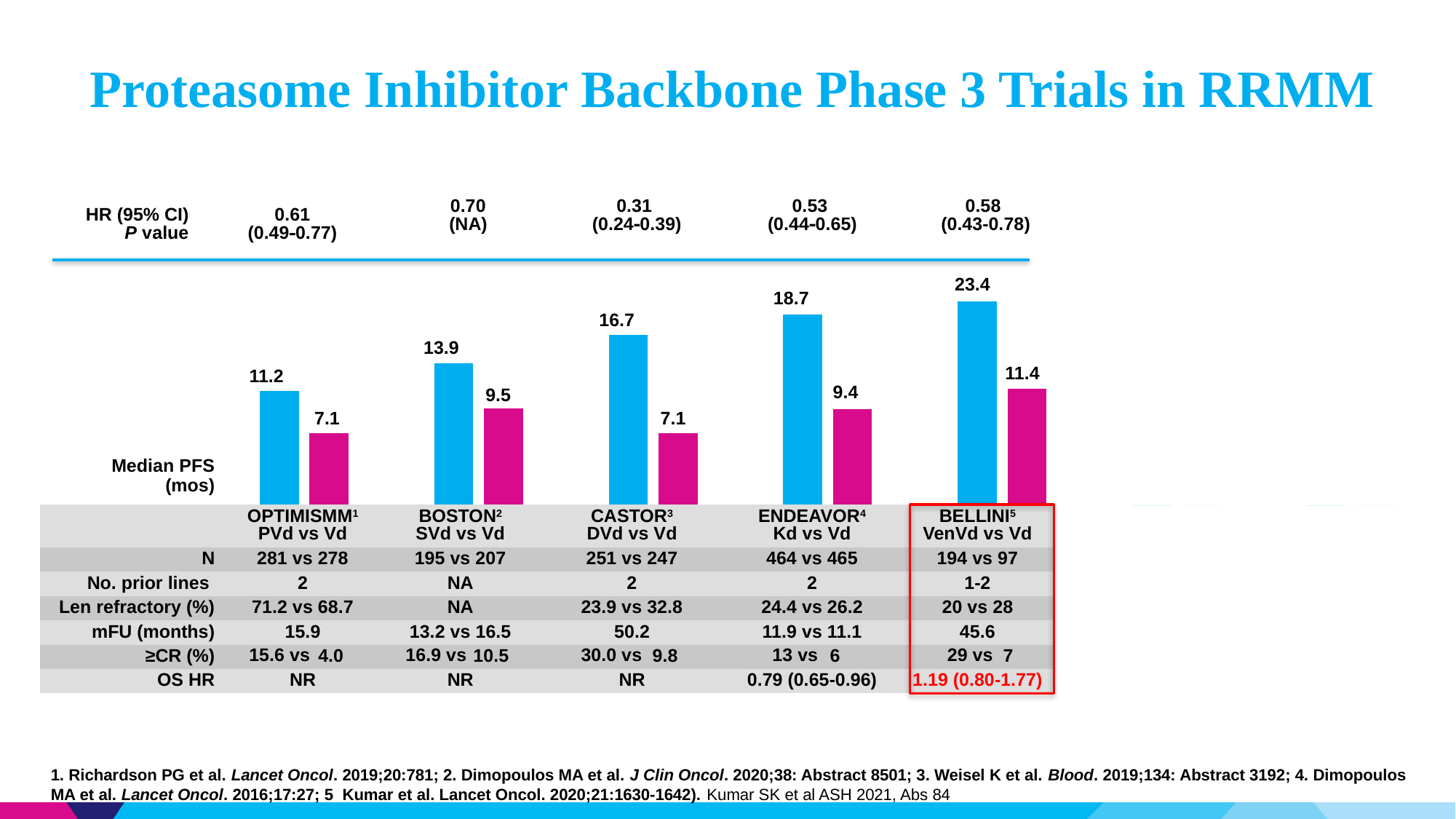
Which trial has the lowest median PFS for its blue (triplet/experimental) bar? OPTIMISMM What is the hazard ratio (95% CI) shown above the CASTOR trial bars? 0.31 (0.24-0.39) How many trials are shown as categories on the bar chart? 5 What is the median PFS in months for the Vd arm (magenta bar) in the BELLINI trial? 11.4 What type of chart is used to display median PFS? Bar chart Which is larger: the median PFS of the Vd arm in BOSTON or the Vd arm in ENDEAVOR? BOSTON (9.5) Do the blue (experimental arm) median PFS bars rise or fall from OPTIMISMM to BELLINI across the x axis? Rise What is the median PFS in months for the Kd arm (blue bar) in the ENDEAVOR trial? 18.7 Which trial has the highest median PFS for its blue (triplet/experimental) bar? BELLINI What is the difference in median PFS between the DVd arm and the Vd arm in the CASTOR trial? 9.6 What is the difference in median PFS between the VenVd arm and the Vd arm in the BELLINI trial? 12.0 What is the median PFS in months for the PVd arm (blue bar) in the OPTIMISMM trial? 11.2